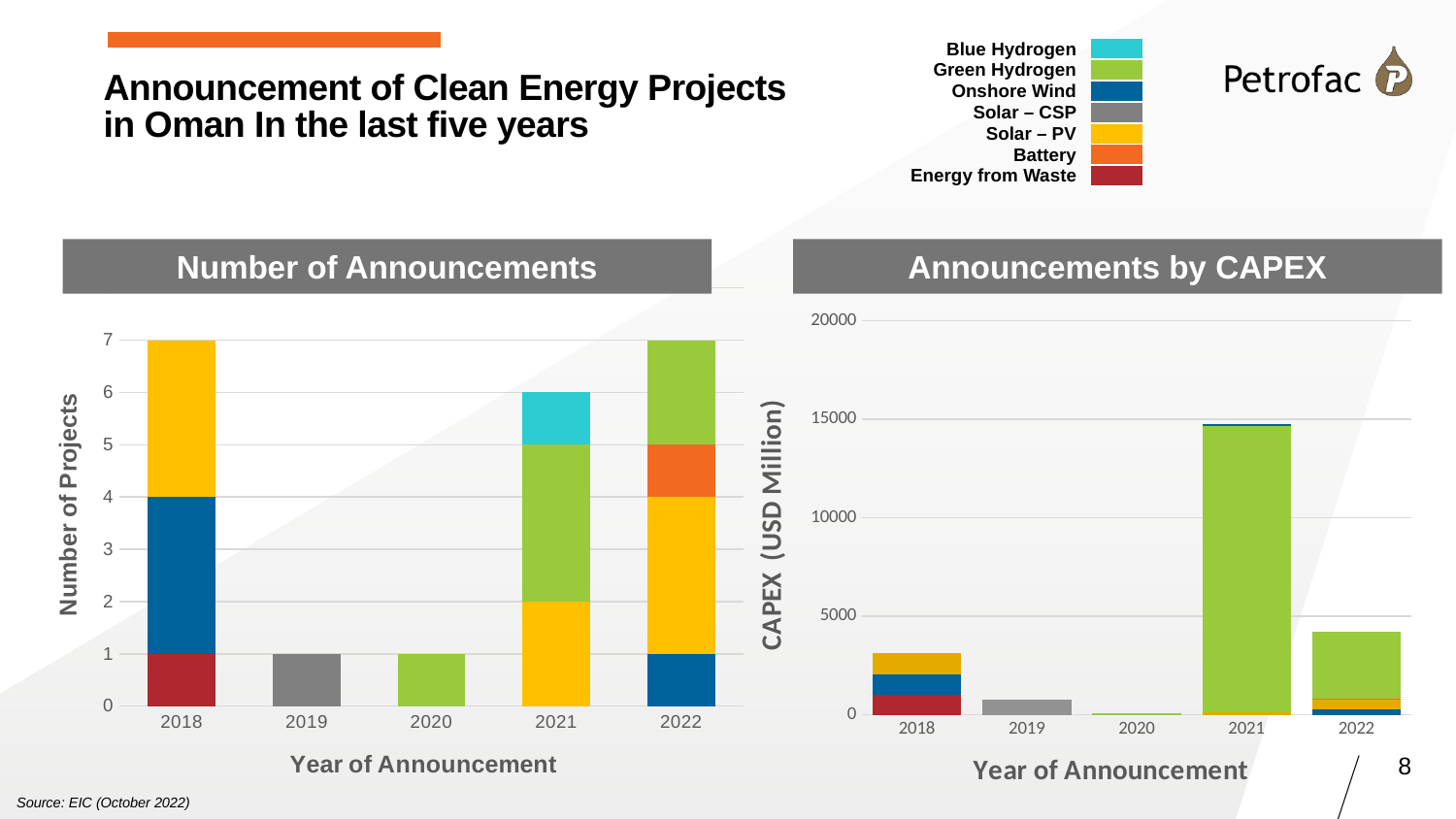
In the 'Number of Announcements' chart, how many projects in total were announced in 2021? 6 In the 'Announcements by CAPEX' chart, which year has the lowest total CAPEX? 2020 In the 'Number of Announcements' chart, how many projects in total were announced in 2018? 7 In the 'Number of Announcements' chart, how many years are shown on the x axis? 5 How many series does the legend at the top of the slide list? 7 In the 'Number of Announcements' chart, how many Green Hydrogen projects were announced in 2021? 3 What kind of chart is the 'Number of Announcements' chart? Stacked bar chart In the 'Number of Announcements' chart, what is the difference between the total number of projects in 2021 and in 2019? 5 In the 'Number of Announcements' chart, how many Onshore Wind projects were announced in 2018? 3 In the 'Announcements by CAPEX' chart, is the total CAPEX for 2021 greater or less than 10000? greater In the 'Number of Announcements' chart, how many Solar – PV projects were announced in 2022? 3 In the 'Announcements by CAPEX' chart, which year has the highest total CAPEX? 2021